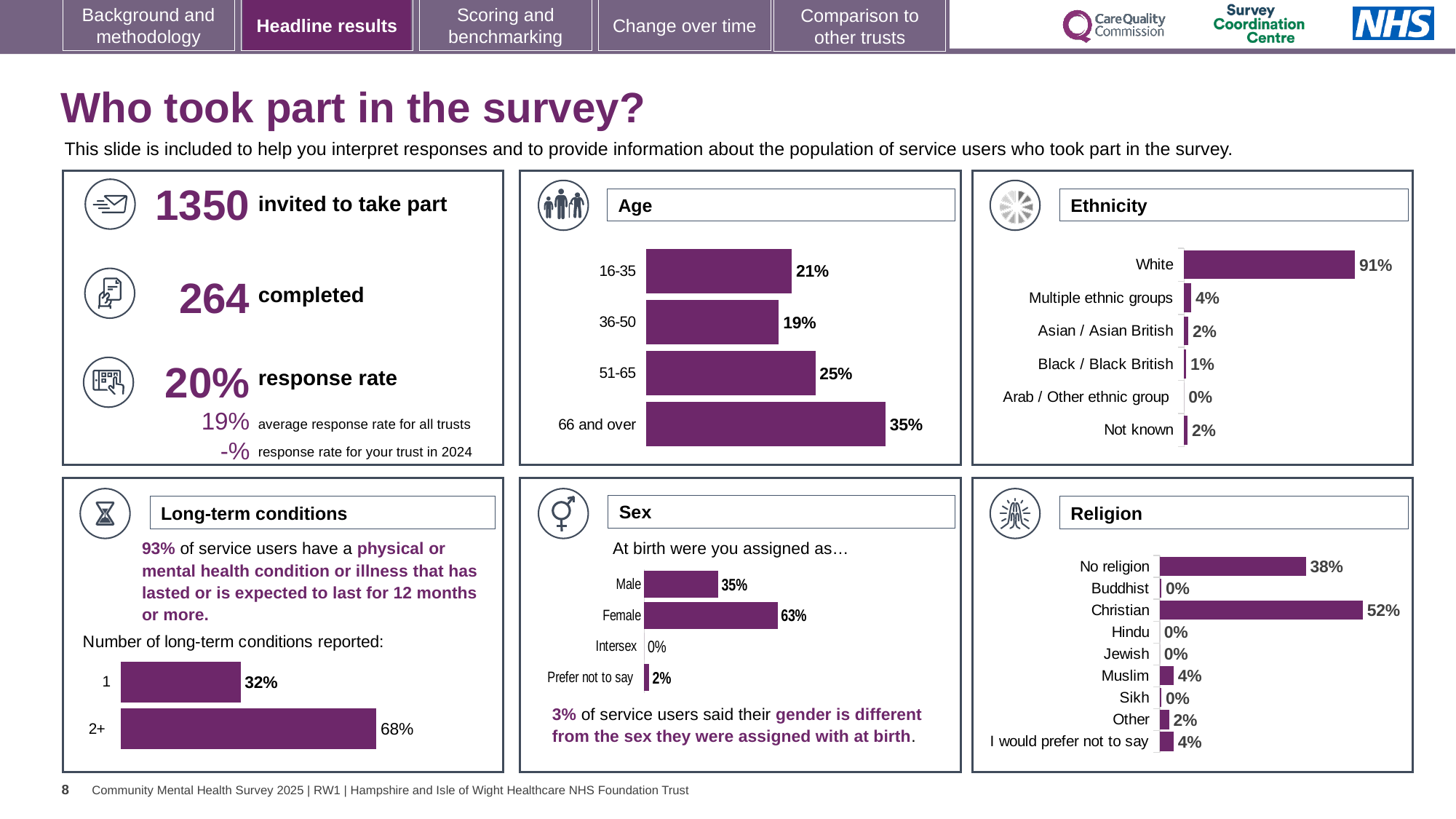
In the Age chart, what percentage of respondents were aged 66 and over? 35% In the Ethnicity chart, which category is larger: Multiple ethnic groups or Asian / Asian British? Multiple ethnic groups In the Age chart, what is the difference between the 51-65 and 16-35 percentages? 4% In the Religion chart, what percentage of respondents reported No religion? 38% In the Long-term conditions chart, what percentage of service users reported 2+ long-term conditions? 68% In the Age chart, which age group has the lowest percentage? 36-50 In the Religion chart, which religion category has the highest percentage? Christian In the Sex chart, what percentage of respondents were assigned Female at birth? 63% In the Ethnicity chart, what percentage of respondents were White? 91% How many ethnicity categories are shown in the Ethnicity chart? 6 In the Sex chart, what is the difference between the Female and Male percentages? 28% What type of chart is used in the Age panel? Bar chart